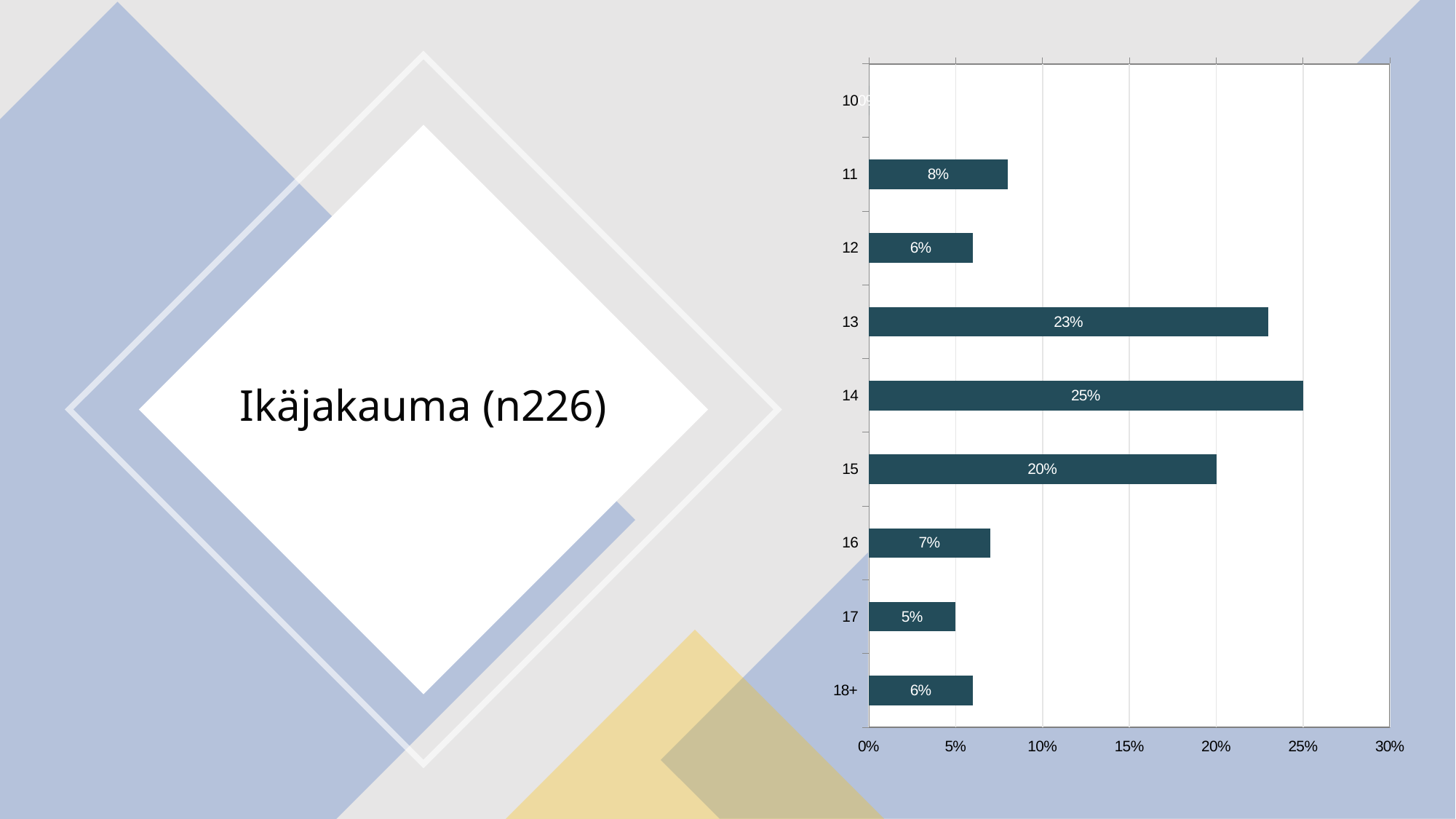
What is the title shown on the slide? Ikäjakauma (n226) What is the value for age 13? 23% Is the value for age 13 greater or less than 20%? greater What is the difference between the values for age 14 and age 15? 5% What kind of chart is shown on the slide? bar chart What is the value for age 17? 5% Which is larger, the value for age 11 or the value for age 16? 11 What is the value for age 14? 25% Which age category has the highest value? 14 Which age category has the lowest value among the labelled bars? 17 What is the value for the 18+ category? 6% What is the maximum value shown on the horizontal axis? 30%